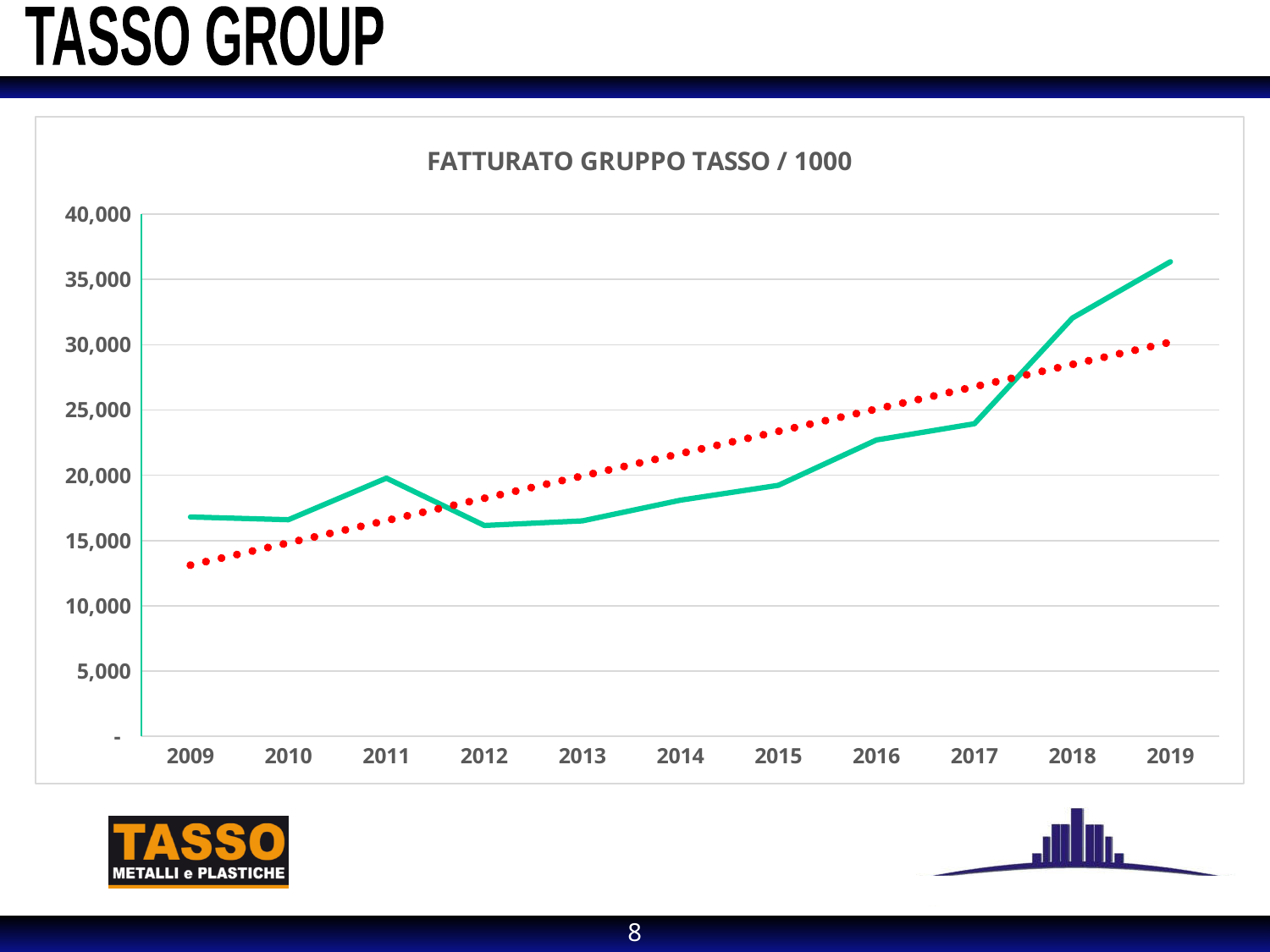
Which year has the larger value, 2011 or 2012? 2011 Is the value for 2019 greater or less than 35,000? greater Is the value for 2016 greater or less than 20,000? greater How many years are plotted along the x axis? 11 Is the value for 2018 greater or less than 30,000? greater Overall, do the values rise or fall from 2009 to 2019? Rise What kind of chart is shown on the slide? Line chart Which year has the larger value, 2017 or 2018? 2018 Which year has the highest value on the green line? 2019 What is the title of the chart? FATTURATO GRUPPO TASSO / 1000